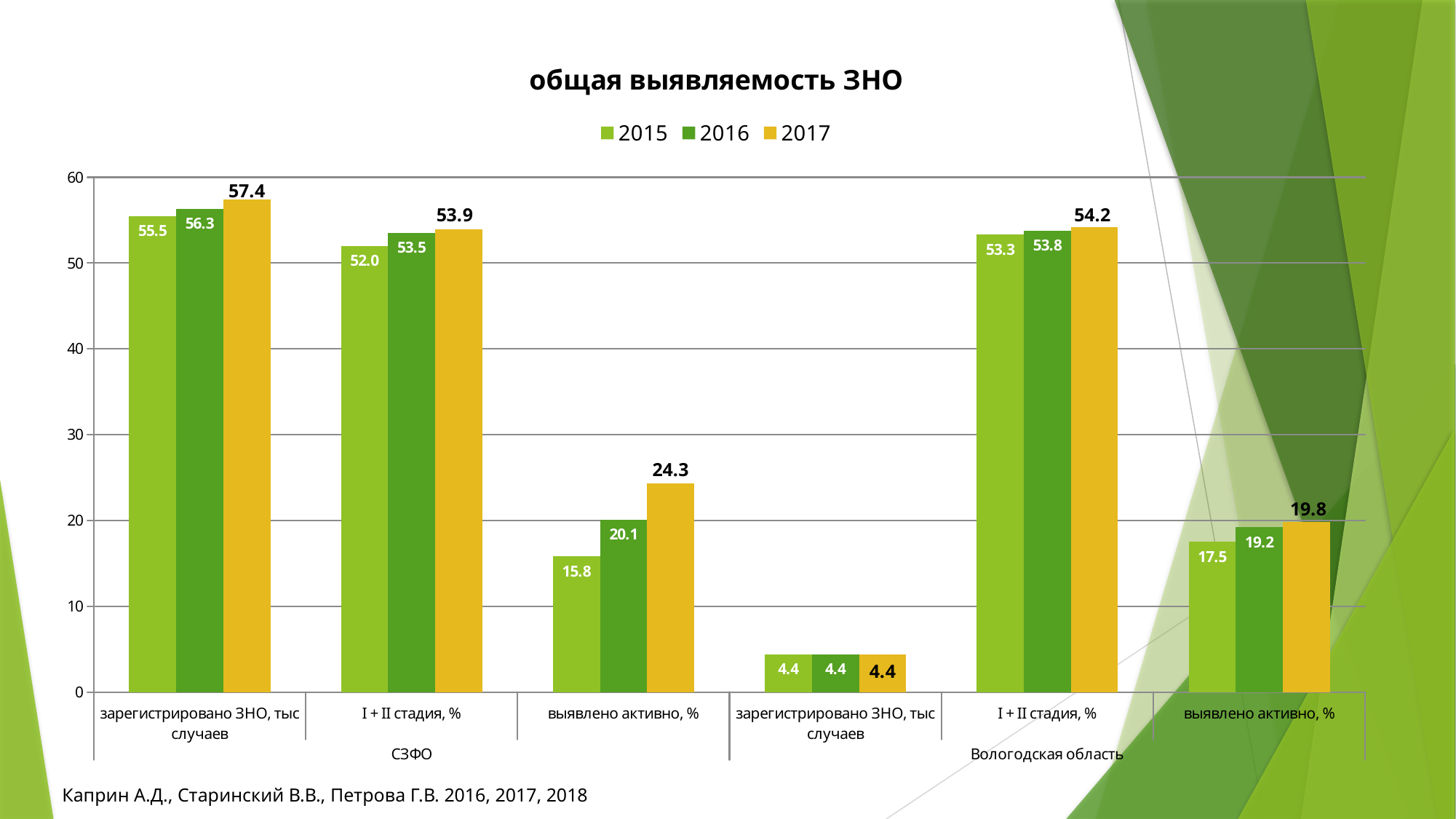
How many series does the legend list? 3 What is the 2017 value for 'зарегистрировано ЗНО, тыс случаев' in Вологодская область? 4.4 Which year has the highest value for 'выявлено активно, %' in Вологодская область? 2017 What is the 2017 value for 'выявлено активно, %' in СЗФО? 24.3 Which is larger: the 2017 value for 'I + II стадия, %' in СЗФО or in Вологодская область? Вологодская область What kind of chart is shown on the slide? bar chart What is the difference between the 2017 and 2015 values for 'выявлено активно, %' in СЗФО? 8.5 What is the 2015 value for 'зарегистрировано ЗНО, тыс случаев' in СЗФО? 55.5 Do the values for 'зарегистрировано ЗНО, тыс случаев' in СЗФО rise or fall from 2015 to 2017? rise Which year has the lowest value for 'I + II стадия, %' in СЗФО? 2015 Is the 2016 value for 'выявлено активно, %' in Вологодская область greater or less than 20? less What is the 2016 value for 'I + II стадия, %' in Вологодская область? 53.8